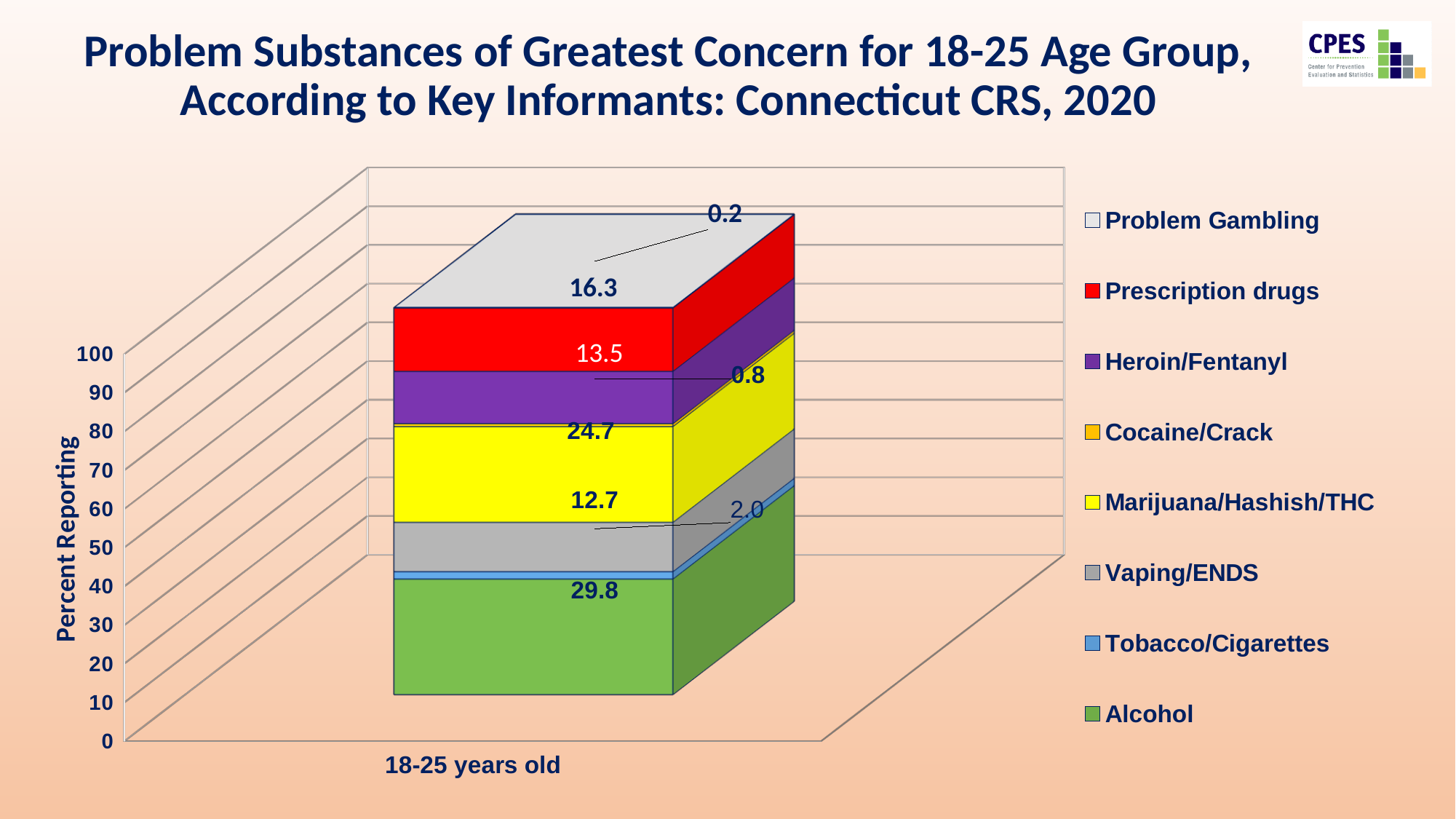
Which series has the smallest value in the stacked bar? Problem Gambling What is the value for Marijuana/Hashish/THC? 24.7 Which series has the largest value in the stacked bar? Alcohol What is the value for Tobacco/Cigarettes? 2.0 What is the label of the vertical axis? Percent Reporting What is the value for Heroin/Fentanyl? 13.5 What is the difference between the values for Alcohol and Marijuana/Hashish/THC? 5.1 Which is larger, the value for Vaping/ENDS or the value for Heroin/Fentanyl? Heroin/Fentanyl How many series does the legend list? 8 What kind of chart is shown on the slide? Stacked bar chart What is the value for Alcohol in the 18-25 years old bar? 29.8 What is the value for Prescription drugs? 16.3